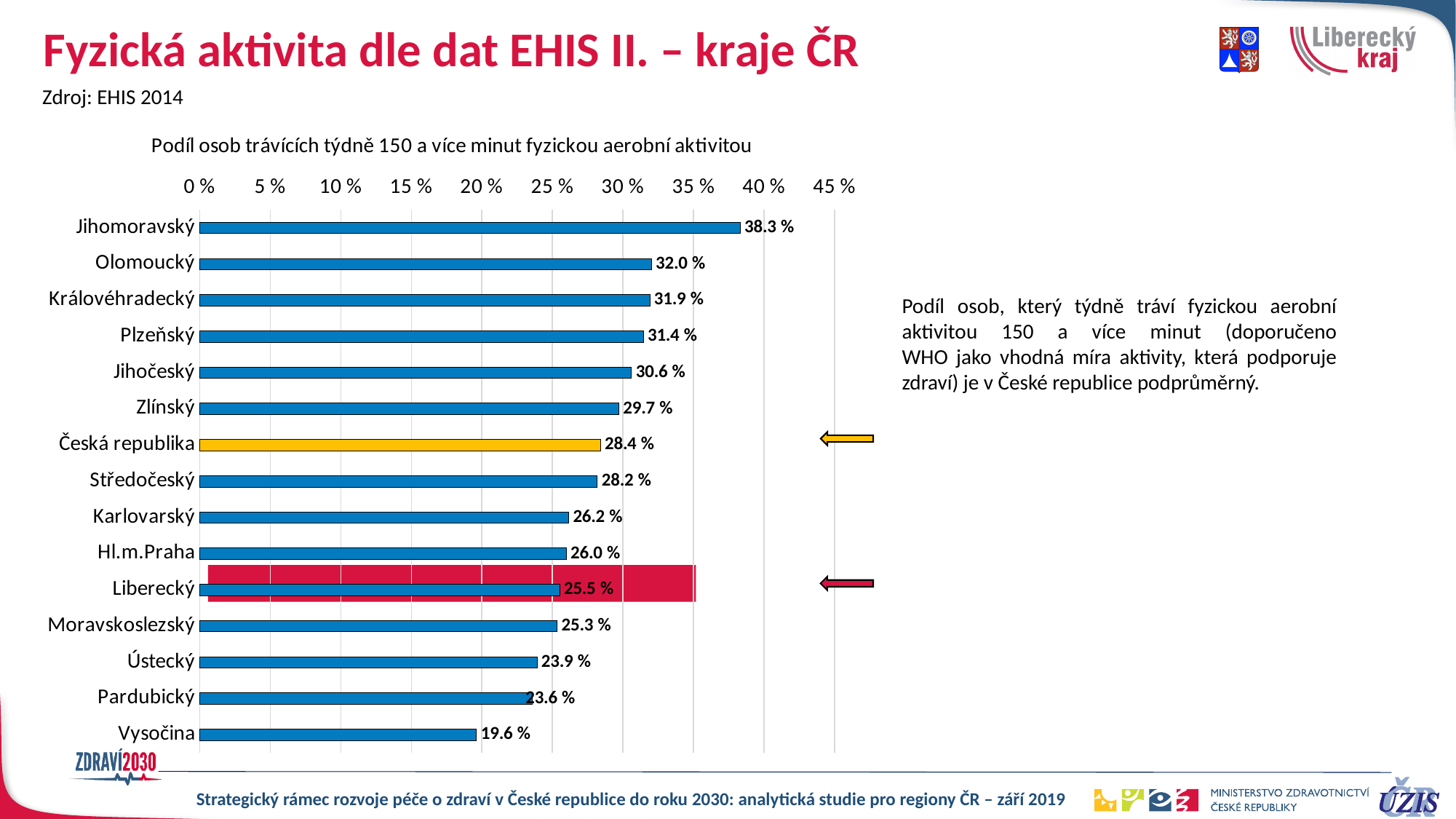
How many categories are shown on the chart? 15 What is the difference between the values for Česká republika and Liberecký? 2.9 % What is the value for Vysočina? 19.6 % What is the difference between the values for Jihomoravský and Vysočina? 18.7 % Is the value for Jihomoravský greater or less than 35 %? greater What is the value for Liberecký? 25.5 % What is the value for Česká republika? 28.4 % Which category has the lowest value? Vysočina What kind of chart is shown on the slide? bar chart What is the title of the chart? Podíl osob trávících týdně 150 a více minut fyzickou aerobní aktivitou Which is larger, the value for Olomoucký or the value for Jihočeský? Olomoucký Which region has the highest value? Jihomoravský